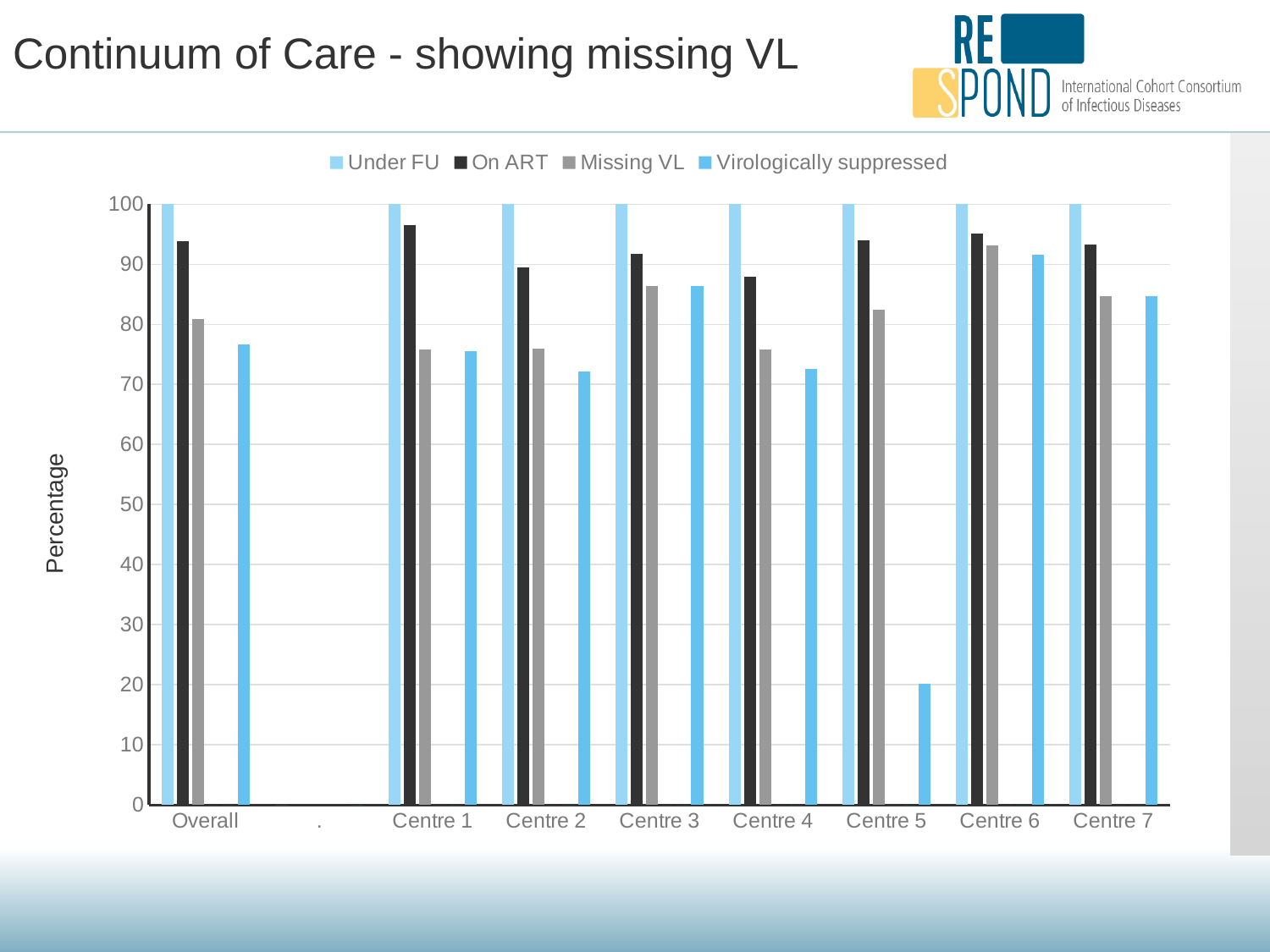
Which centre has the lowest Virologically suppressed value? Centre 5 What is the Under FU value for Overall? 100 What is the label of the y axis? Percentage What kind of chart is shown on the slide? bar chart Is the Missing VL value for Centre 6 greater or less than 90? greater Which is larger, the Missing VL value for Centre 3 or for Centre 4? Centre 3 How many series does the legend list? 4 Which is larger, the Virologically suppressed value for Centre 6 or for Centre 7? Centre 6 Is the On ART value for Centre 1 greater or less than 90? greater Is the Virologically suppressed value for Centre 4 greater or less than 80? less What is the Under FU value for Centre 4? 100